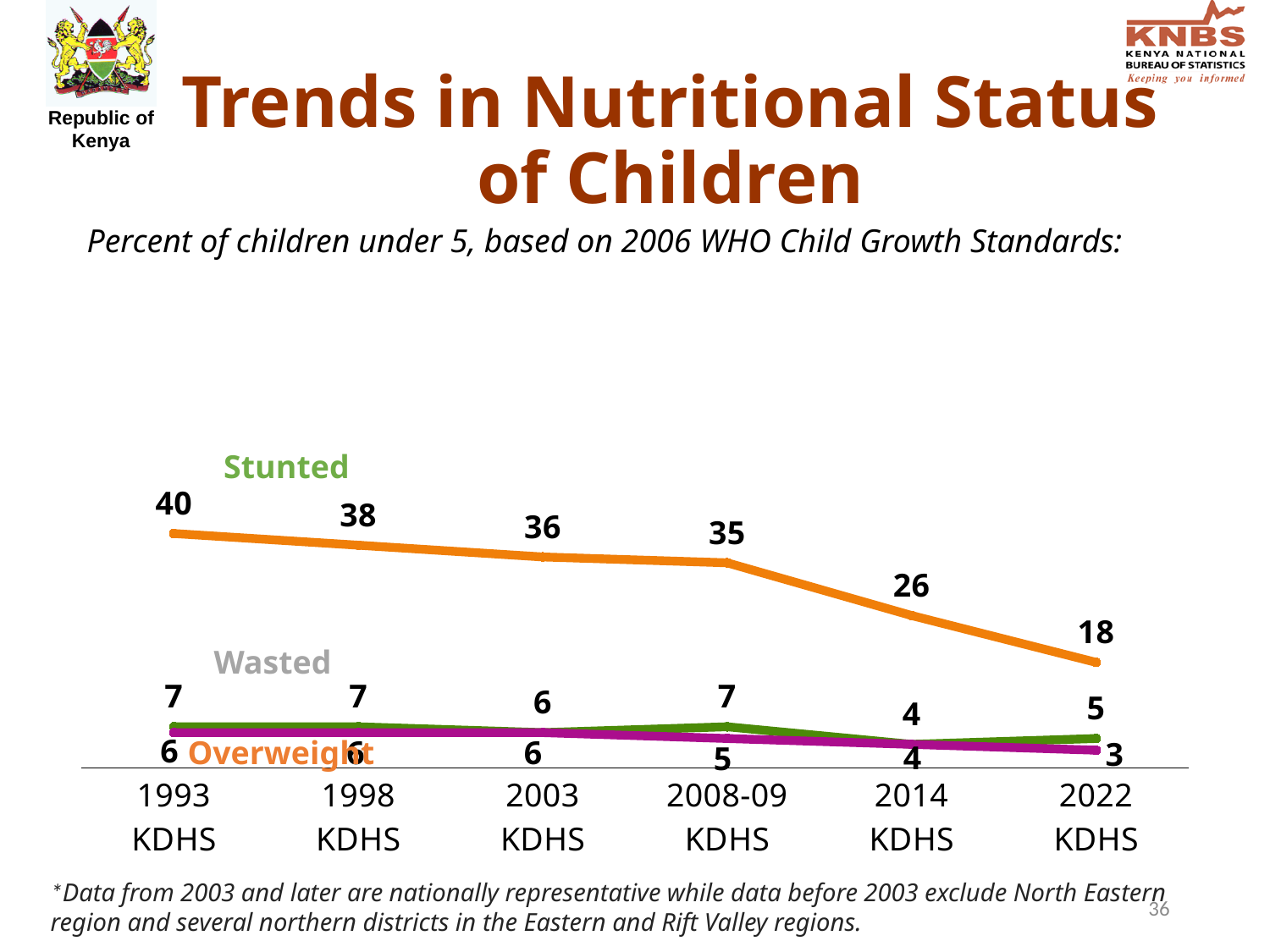
Which survey has the highest stunted value? 1993 KDHS Which survey has the lowest stunted value? 2022 KDHS Does the stunted line rise or fall from 1993 KDHS to 2022 KDHS? fall How many survey points are shown on the x axis? 6 What is the stunted value for 2014 KDHS? 26 What is the stunted value for 1993 KDHS? 40 What is the overweight value for 2022 KDHS? 3 What is the wasted value for 2008-09 KDHS? 7 By how much did the stunted value fall from 1993 KDHS to 2022 KDHS? 22 What kind of chart is shown on the slide? line chart What is the difference between the stunted values for 2008-09 KDHS and 2014 KDHS? 9 What is the stunted value for 2022 KDHS? 18